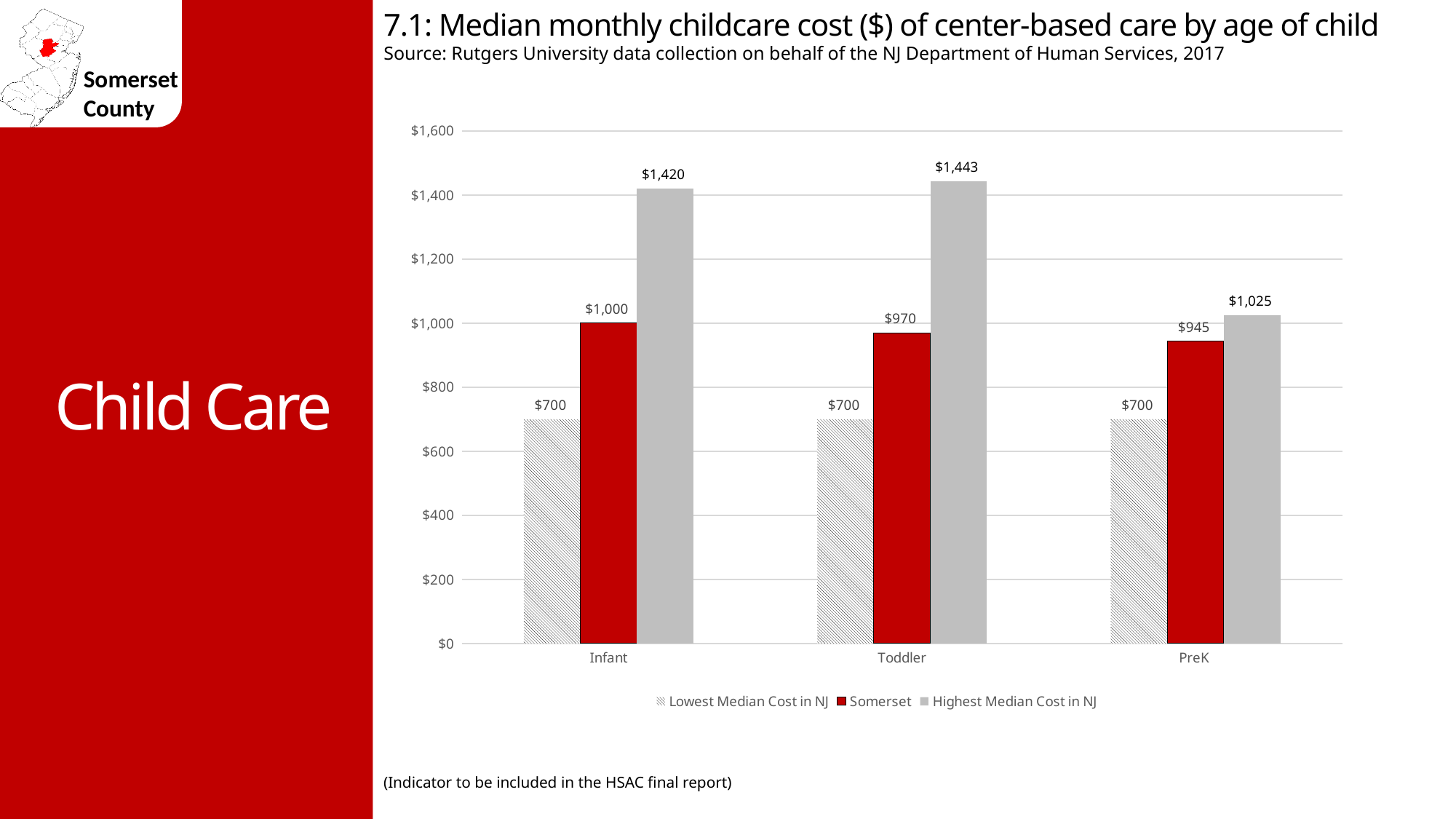
Which age group has the highest Somerset median monthly cost? Infant Which age group has the lowest Highest Median Cost in NJ? PreK What is the Somerset median monthly childcare cost for Infant care? $1,000 What is the Lowest Median Cost in NJ for PreK care? $700 How many age groups are shown on the x axis? 3 What is the difference between the Somerset cost for Toddler care and the Somerset cost for PreK care? $25 Which is larger: the Somerset cost for PreK or the Highest Median Cost in NJ for PreK? Highest Median Cost in NJ for PreK How many series does the legend list? 3 What is the Highest Median Cost in NJ for Toddler care? $1,443 Do the Somerset values rise or fall from Infant to PreK? Fall What is the difference between the Highest Median Cost in NJ and the Somerset cost for Infant care? $420 What kind of chart is shown on the slide? Bar chart